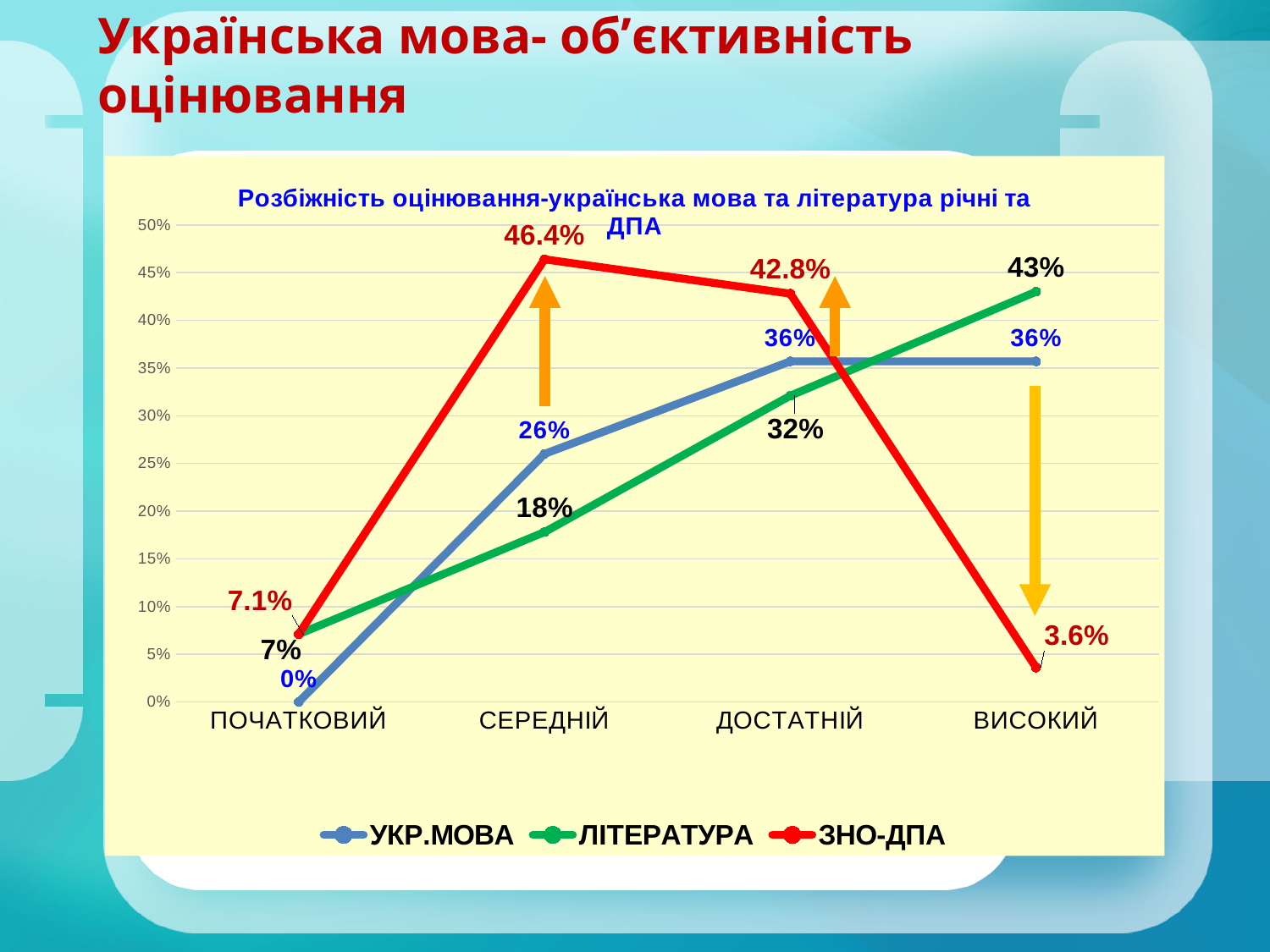
What is the value of ЗНО-ДПА for СЕРЕДНІЙ? 46.4% For ВИСОКИЙ, which is larger: the ЛІТЕРАТУРА value or the ЗНО-ДПА value? ЛІТЕРАТУРА What is the difference between the ЗНО-ДПА value and the УКР.МОВА value for СЕРЕДНІЙ? 20.4% Do the ЛІТЕРАТУРА values rise or fall from ПОЧАТКОВИЙ to ВИСОКИЙ? rise For which category is the ЗНО-ДПА value highest? СЕРЕДНІЙ How many categories are shown on the x axis? 4 What kind of chart is shown on the slide? line chart What is the value of ЛІТЕРАТУРА for ВИСОКИЙ? 43% How many series does the legend list? 3 What is the value of УКР.МОВА for ПОЧАТКОВИЙ? 0% What is the value of ЗНО-ДПА for ВИСОКИЙ? 3.6% For which category is the ЛІТЕРАТУРА value lowest? ПОЧАТКОВИЙ